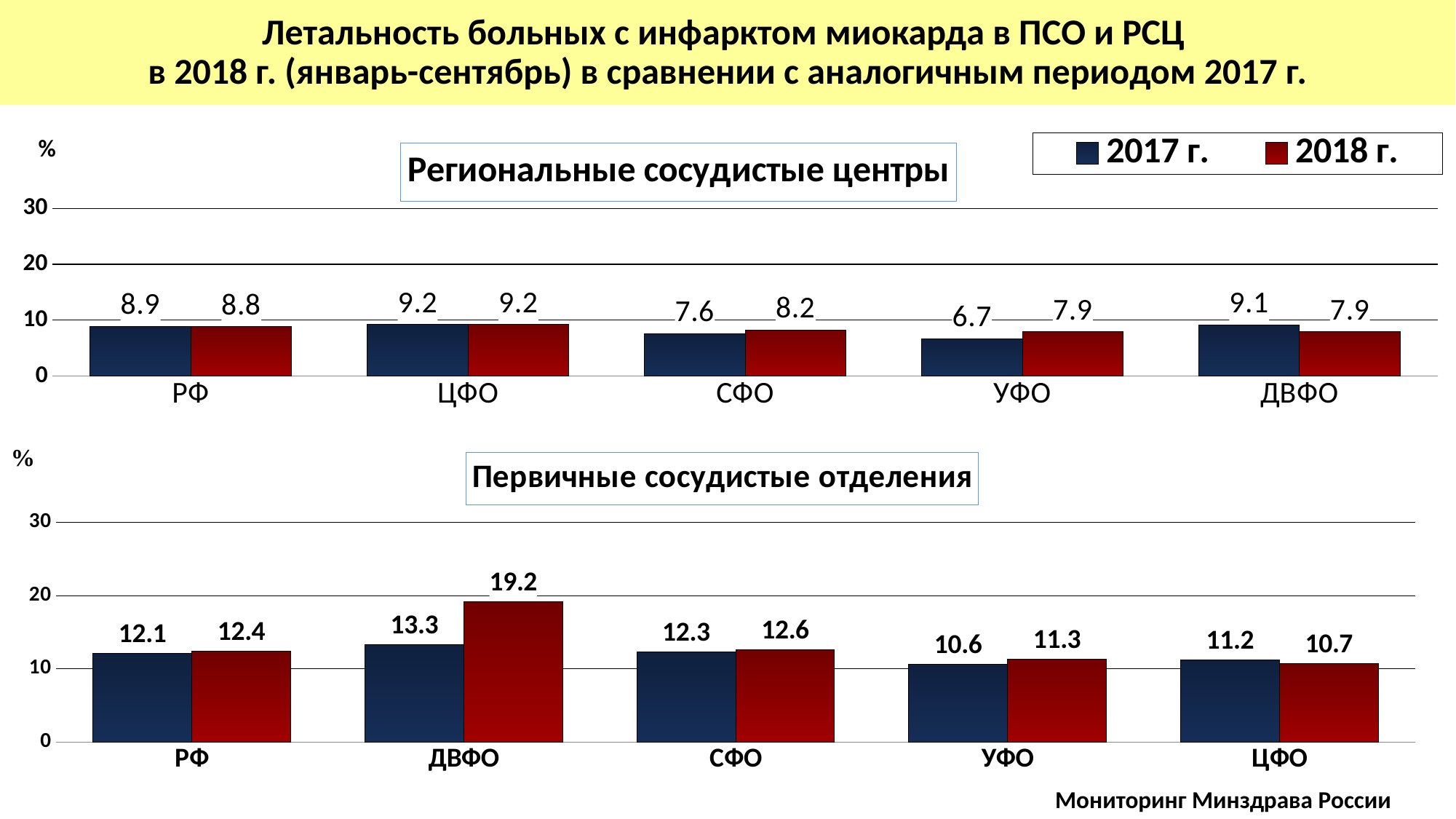
How many series does the legend list for the charts on the slide? 2 In the chart 'Первичные сосудистые отделения', what is the difference between the 2018 г. and 2017 г. values for ДВФО? 5.9 In the chart 'Первичные сосудистые отделения', which category has the lowest value for 2017 г.? УФО In the chart 'Региональные сосудистые центры', what is the value for СФО in 2018 г.? 8.2 What type of chart is 'Первичные сосудистые отделения'? Bar chart In the chart 'Региональные сосудистые центры', what is the difference between the 2017 г. and 2018 г. values for ДВФО? 1.2 In the chart 'Региональные сосудистые центры', what is the value for УФО in 2017 г.? 6.7 In the chart 'Региональные сосудистые центры', how many categories are shown on the x axis? 5 In the chart 'Первичные сосудистые отделения', what is the value for ДВФО in 2018 г.? 19.2 In the chart 'Первичные сосудистые отделения', which category has the highest value for 2018 г.? ДВФО In the chart 'Региональные сосудистые центры', which category has the lowest value for 2017 г.? УФО In the chart 'Первичные сосудистые отделения', which is larger for ЦФО: the 2017 г. value or the 2018 г. value? 2017 г.